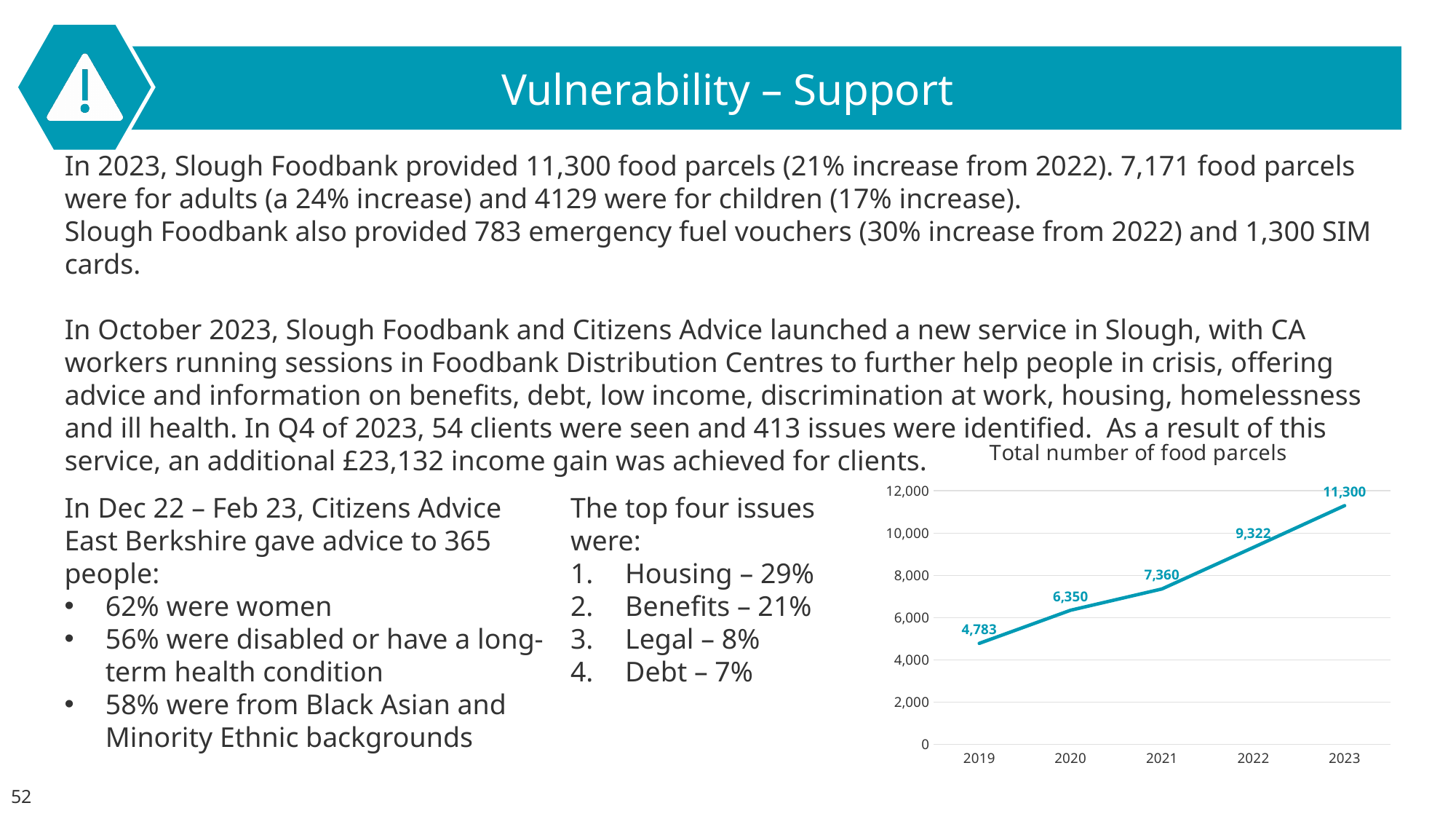
What kind of chart is used to show the total number of food parcels? Line chart How many years are plotted on the chart? 5 What is the total number of food parcels shown for 2021? 7,360 Do the values rise or fall from 2019 to 2023? Rise What is the total number of food parcels shown for 2019? 4,783 Is the value for 2022 greater or less than 8,000? greater What is the total number of food parcels shown for 2023? 11,300 Which year has the lowest total number of food parcels? 2019 What is the difference in food parcels between 2023 and 2022? 1,978 Which year had more food parcels, 2020 or 2021? 2021 What is the difference in food parcels between 2020 and 2019? 1,567 Which year has the highest total number of food parcels? 2023